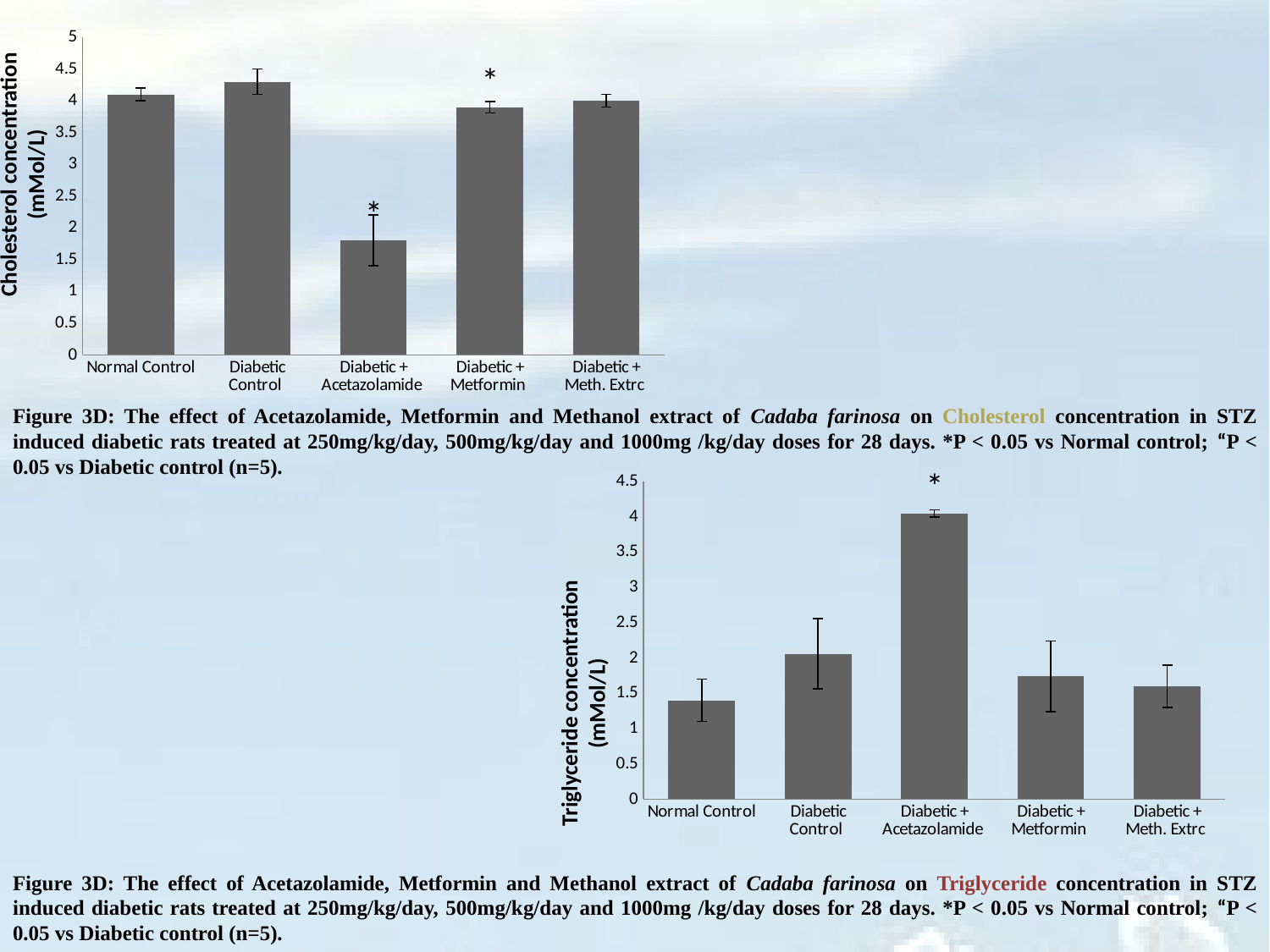
In the triglyceride concentration chart (bottom), which group has the highest triglyceride concentration? Diabetic + Acetazolamide In the cholesterol concentration chart (top), which is larger, the value for Diabetic Control or the value for Diabetic + Acetazolamide? Diabetic Control In the triglyceride concentration chart (bottom), which is larger, the value for Diabetic Control or the value for Normal Control? Diabetic Control In the cholesterol concentration chart (top), is the value for Diabetic Control greater or less than 4? greater In the triglyceride concentration chart (bottom), is the value for Normal Control greater or less than 1.5? less In the cholesterol concentration chart (top), how many treatment groups are plotted? 5 In the triglyceride concentration chart (bottom), which group has the lowest triglyceride concentration? Normal Control In the triglyceride concentration chart (bottom), what is the label of the vertical axis? Triglyceride concentration (mMol/L) In the cholesterol concentration chart (top), which group has the lowest cholesterol concentration? Diabetic + Acetazolamide In the cholesterol concentration chart (top), is the value for Diabetic + Acetazolamide greater or less than 2? less In the cholesterol concentration chart (top), what kind of chart is shown? bar chart